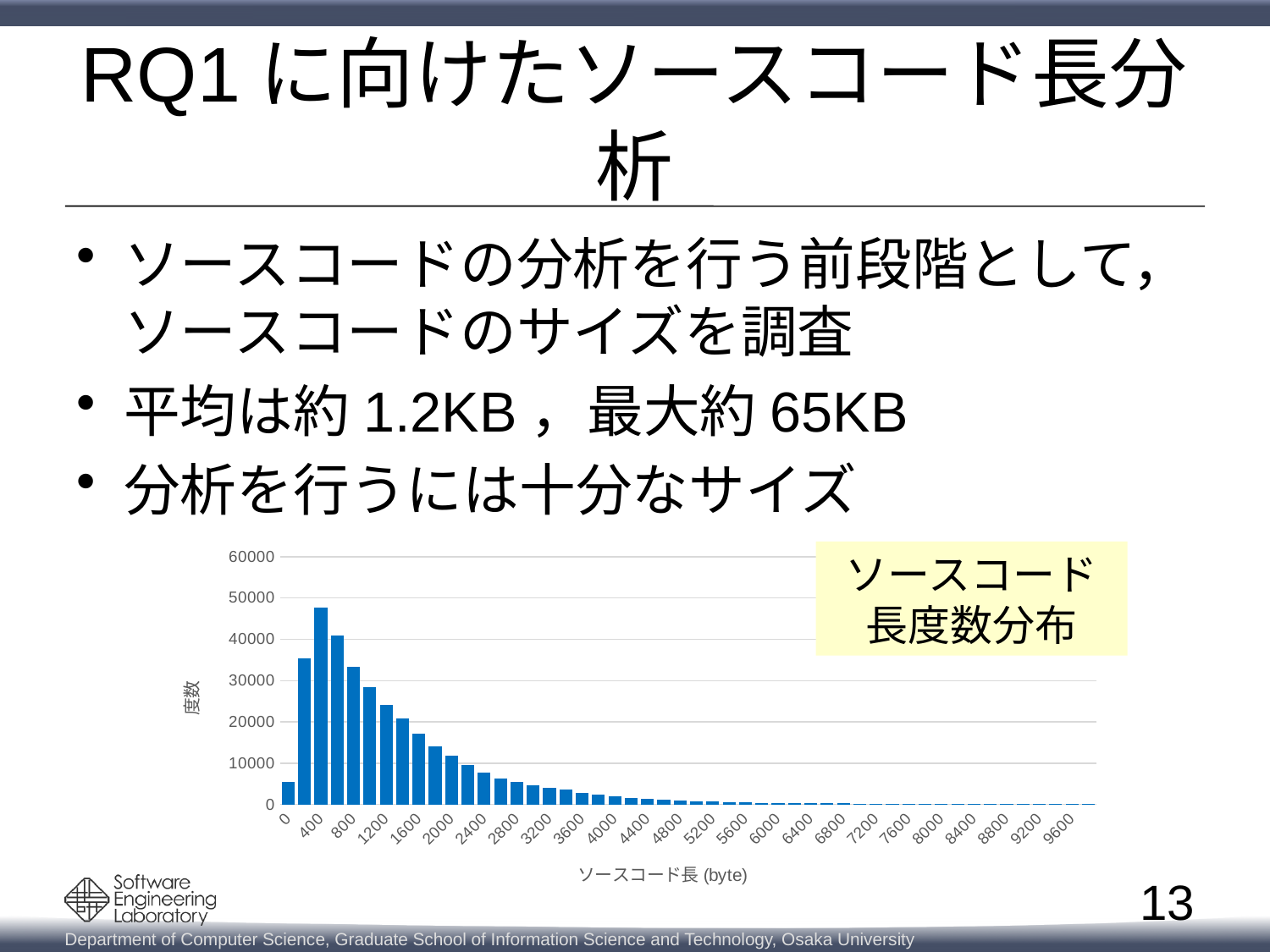
What is the label of the x axis of the chart? ソースコード長 (byte) Is the value of the bar at 1600 greater or less than 20000? less Which bar is taller, the one at 800 or the one at 1200? 800 Is the value of the bar at 1200 greater or less than 30000? less At which x-axis tick does the tallest bar appear? 400 Is the value of the bar at 0 greater or less than 10000? less What kind of chart is shown on the slide? bar chart After the peak at 400, do the bar values rise or fall as source code length increases along the x axis? fall What is the title shown in the yellow box next to the chart? ソースコード長度数分布